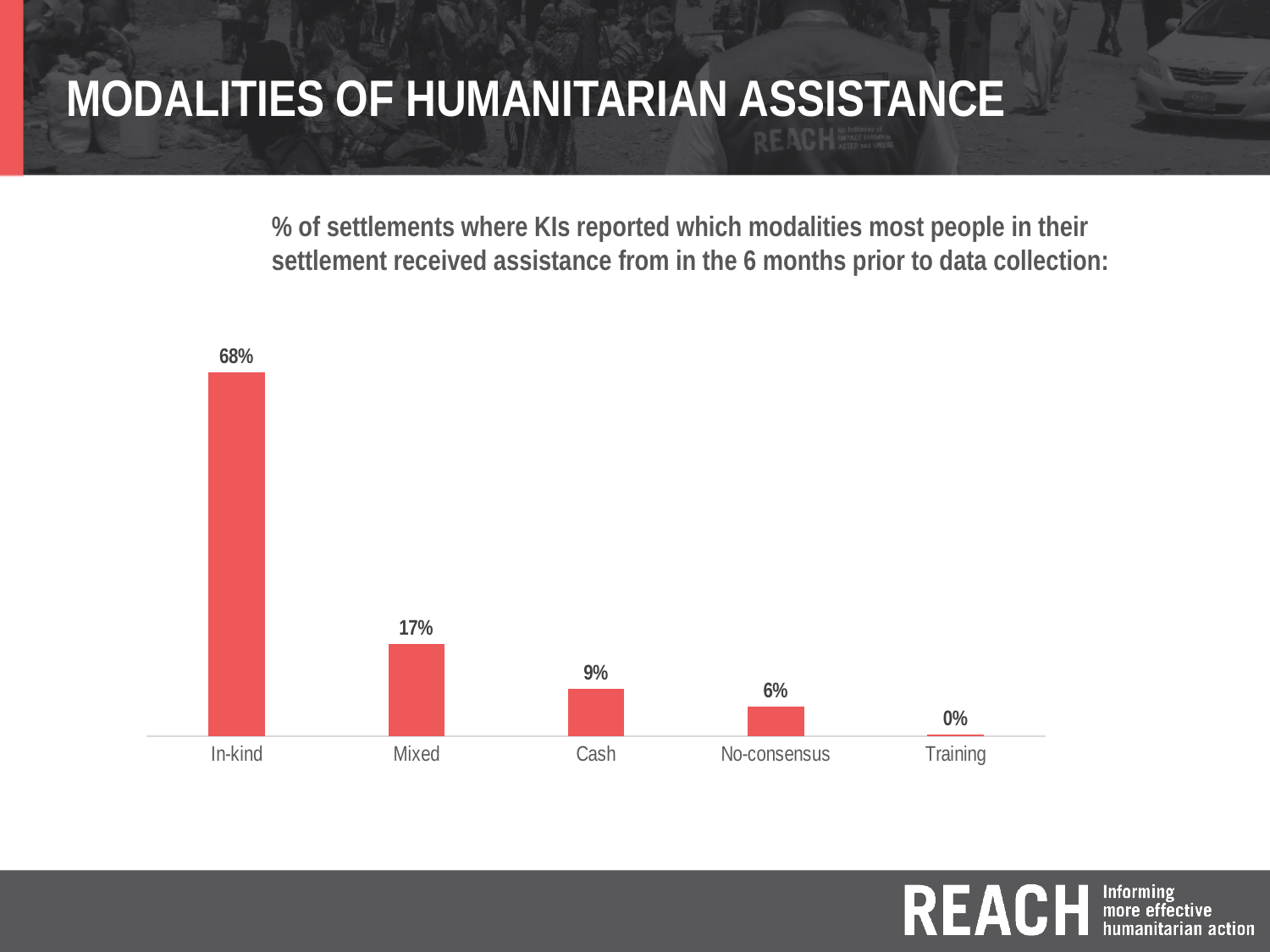
What kind of chart is shown on the slide? Bar chart What percentage of settlements reported In-kind as the modality of assistance? 68% What is the value shown for Training? 0% How many modality categories are shown on the chart? 5 Which is larger, the value for Cash or the value for No-consensus? Cash Which modality has the highest percentage of settlements? In-kind What is the difference in percentage points between In-kind and Mixed? 51 What is the value shown for No-consensus? 6% Do the values rise or fall moving from left to right across the categories? Fall What is the value shown for Mixed? 17% What is the value shown for Cash? 9% Which modality has the lowest percentage of settlements? Training